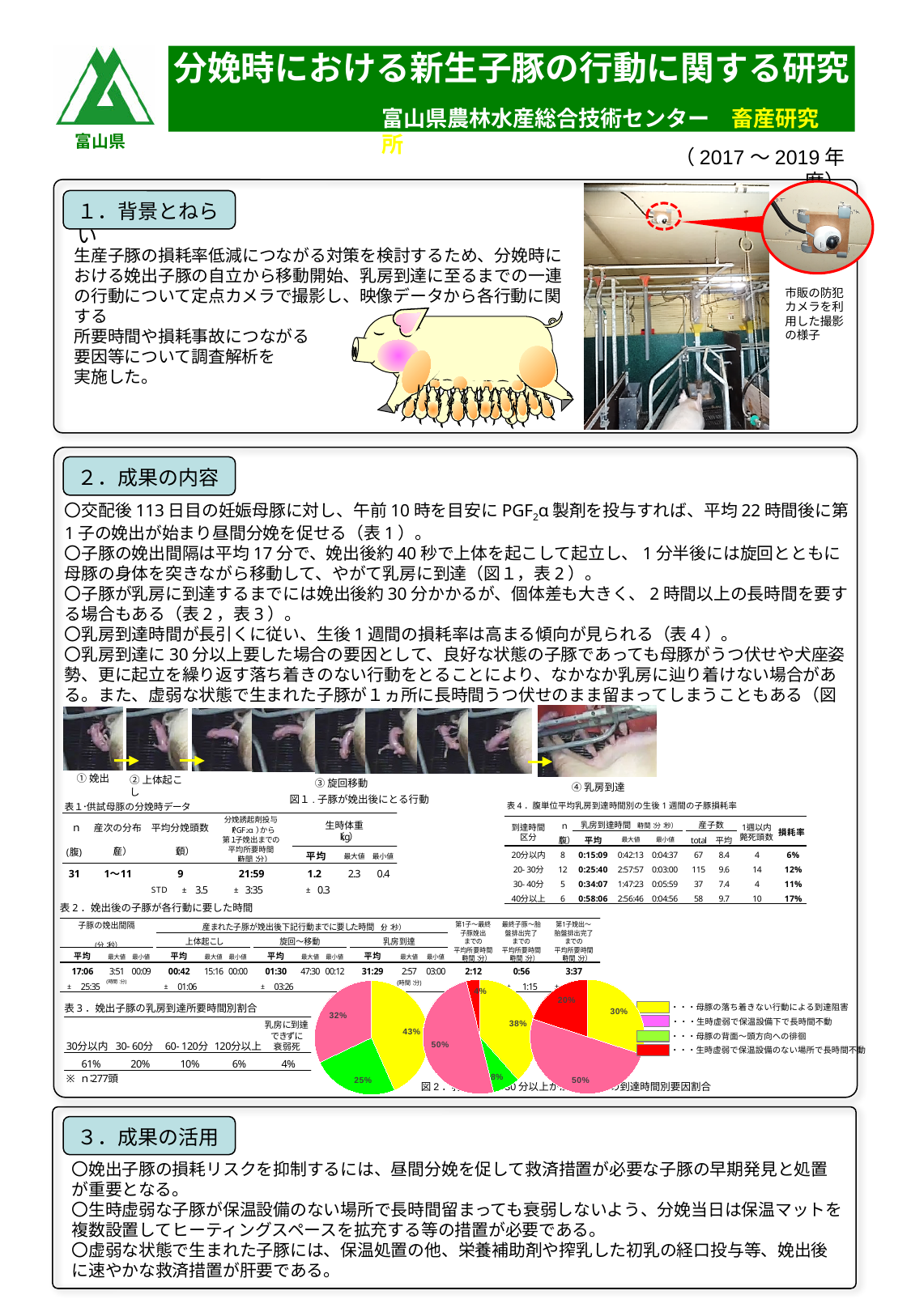
In the left pie chart of 図2, what is the smallest slice's share? 25% In the left pie chart of 図2, what is the difference between the 43% slice and the 32% slice? 11 percentage points How many entries does the legend of 図2 list? 4 How many pie charts are shown in 図2? 3 In the right pie chart of 図2, what share is shown for the red slice? 20% In the legend of 図2, which colour represents 母豚の背面～頭方向への徘徊? green In the middle pie chart of 図2, what is the largest slice's share? 50% In the right pie chart of 図2, which is larger, the yellow slice or the pink slice? the pink slice In the left pie chart of 図2, what is the largest slice's share? 43% What kind of chart is used in 図2 at the bottom of the slide? pie chart In the right pie chart of 図2, what is the difference between the 50% slice and the 30% slice? 20 percentage points In the middle pie chart of 図2, what share is shown for the green slice? 8%